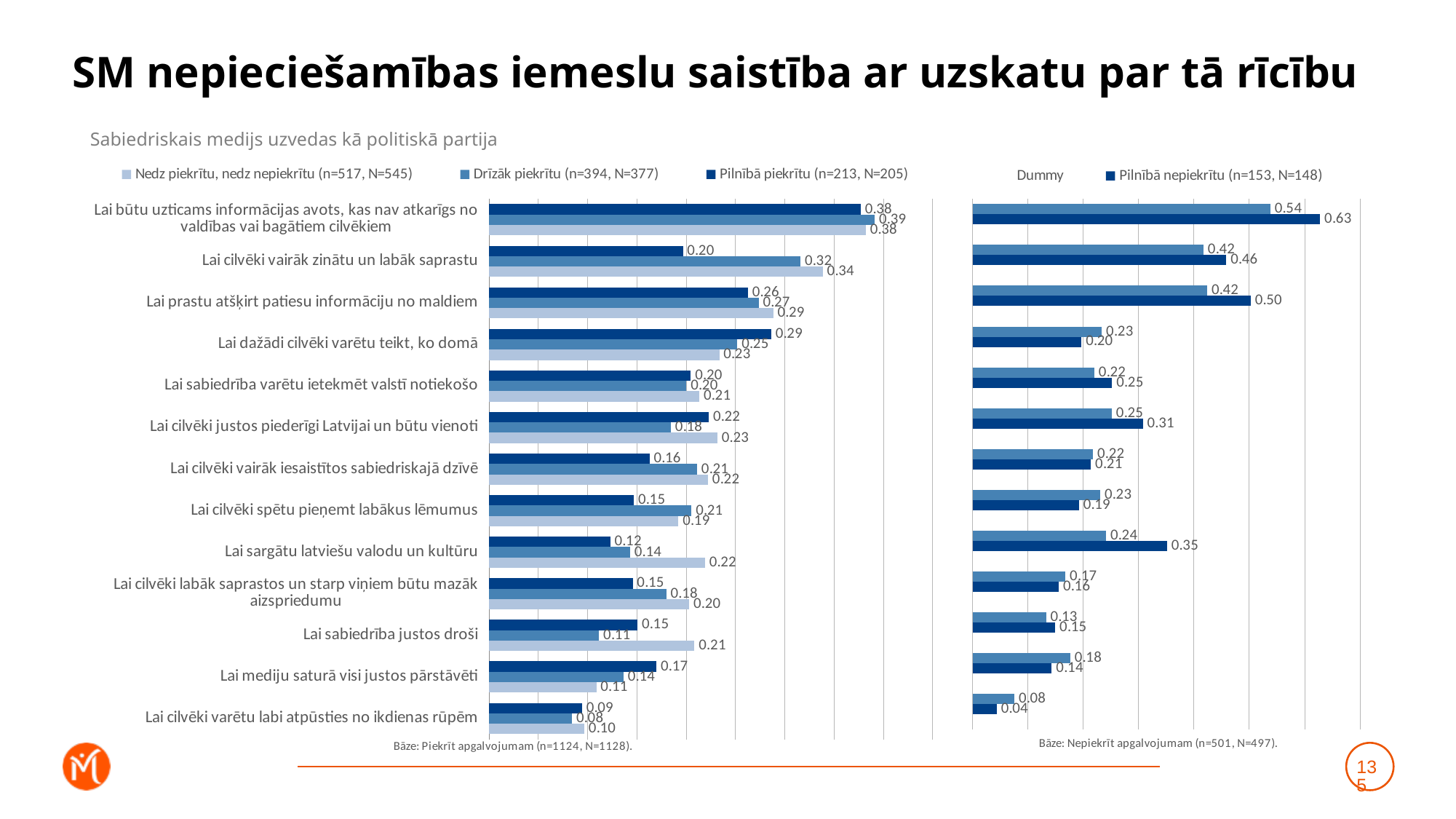
How many categories are shown in the left chart? 13 In the left chart, what is the value of 'Pilnībā piekrītu' for 'Lai cilvēki vairāk zinātu un labāk saprastu'? 0.20 In the right chart, what is the value of 'Pilnībā nepiekrītu' for 'Lai sargātu latviešu valodu un kultūru'? 0.35 In the left chart, for 'Lai sabiedrība justos droši', which is larger: 'Pilnībā piekrītu' or 'Drīzāk piekrītu'? Pilnībā piekrītu How many series does the legend of the left chart list? 3 In the left chart, what is the difference between the 'Nedz piekrītu, nedz nepiekrītu' and 'Pilnībā piekrītu' values for 'Lai cilvēki vairāk zinātu un labāk saprastu'? 0.14 In the left chart, what is the value of 'Nedz piekrītu, nedz nepiekrītu' for 'Lai sargātu latviešu valodu un kultūru'? 0.22 What type of chart is used on this slide? Bar chart In the right chart, what is the value of 'Pilnībā nepiekrītu' for 'Lai būtu uzticams informācijas avots, kas nav atkarīgs no valdības vai bagātiem cilvēkiem'? 0.63 In the right chart, which category has the lowest 'Pilnībā nepiekrītu' value? Lai cilvēki varētu labi atpūsties no ikdienas rūpēm In the right chart, for 'Lai prastu atšķirt patiesu informāciju no maldiem', is the 'Pilnībā nepiekrītu' value greater or less than 0.40? greater In the left chart, which category has the highest 'Drīzāk piekrītu' value? Lai būtu uzticams informācijas avots, kas nav atkarīgs no valdības vai bagātiem cilvēkiem